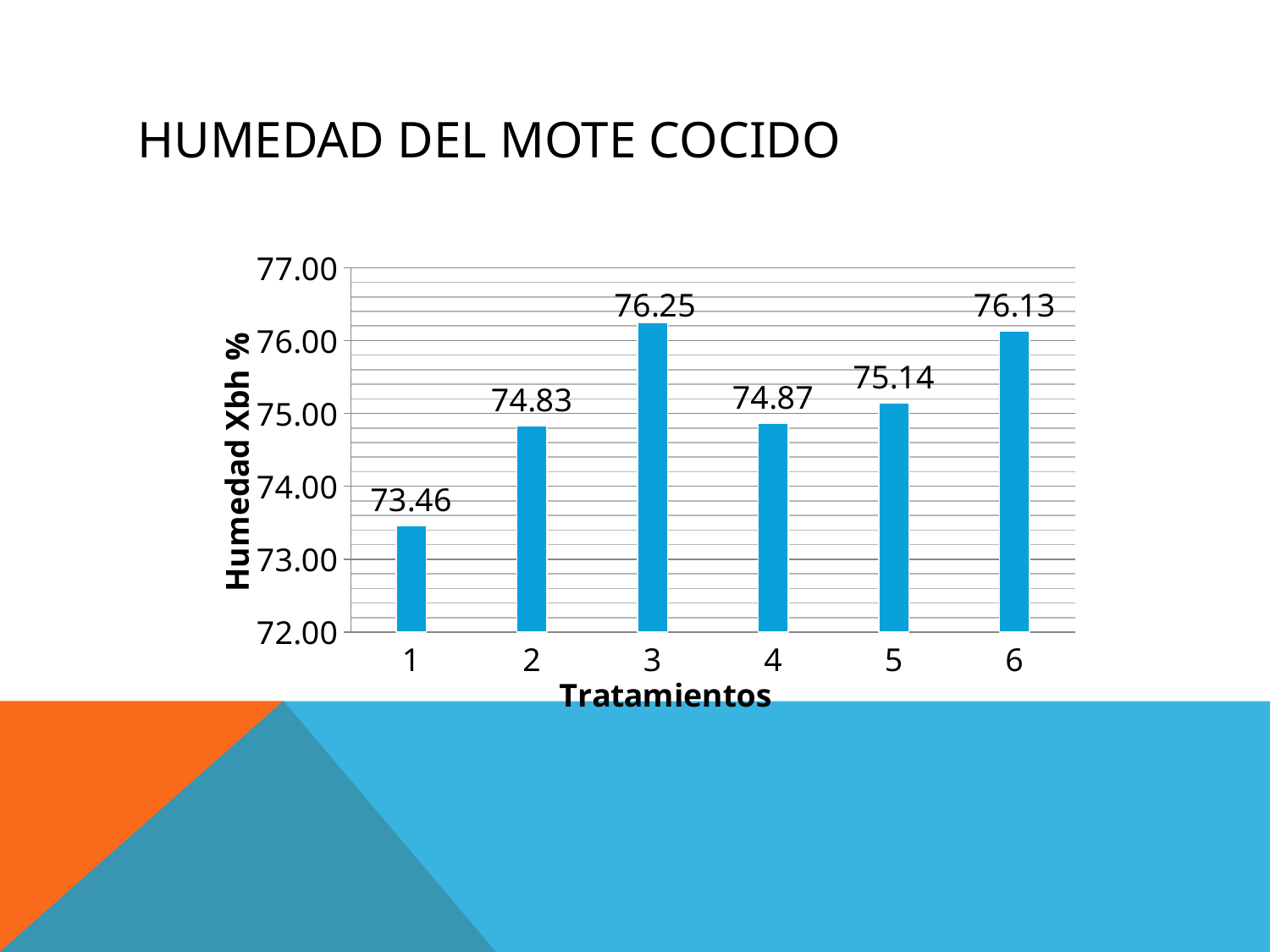
What kind of chart is shown on the slide? Bar chart Which has a higher humidity value, treatment 2 or treatment 6? Treatment 6 Which treatment has the lowest humidity value? 1 Which treatment has the highest humidity value? 3 What is the label of the y axis? Humedad Xbh % What is the humidity value for treatment 3? 76.25 What is the humidity value for treatment 5? 75.14 What is the difference between the humidity values of treatment 3 and treatment 1? 2.79 Is the value for treatment 1 greater or less than 74.00? less What is the humidity value for treatment 1? 73.46 How many treatments are shown on the x axis? 6 What is the humidity value for treatment 6? 76.13